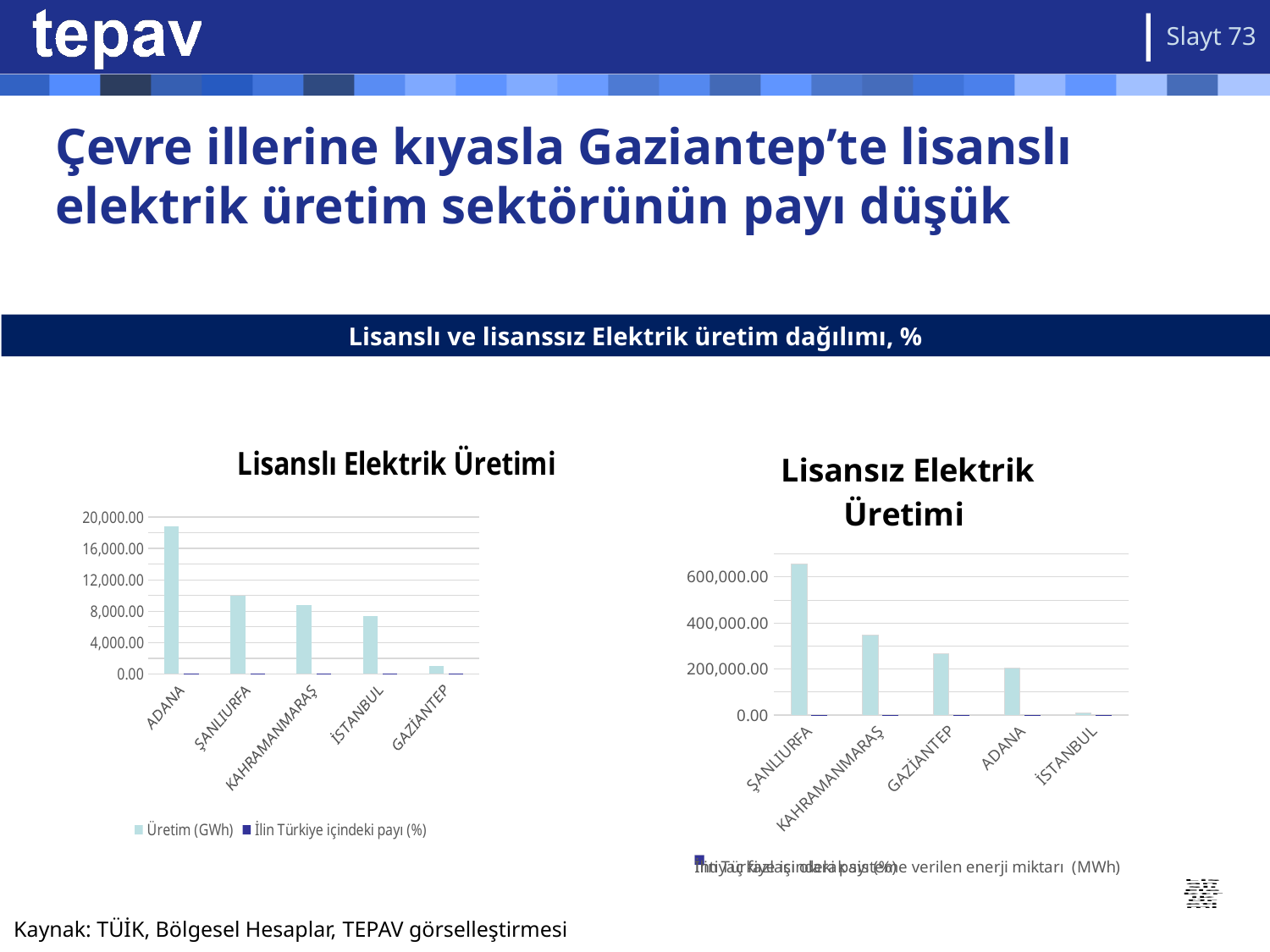
In the 'Lisanslı Elektrik Üretimi' chart, is the Üretim (GWh) value for GAZİANTEP greater or less than 4,000.00? less How many provinces are shown on the x axis of the 'Lisanslı Elektrik Üretimi' chart? 5 In the 'Lisansız Elektrik Üretimi' chart, do the tall bars rise or fall from left to right along the x axis? Fall In the 'Lisanslı Elektrik Üretimi' chart, which province has the highest Üretim (GWh) bar? ADANA In the 'Lisansız Elektrik Üretimi' chart, which province has the tallest bar? ŞANLIURFA In the 'Lisanslı Elektrik Üretimi' chart, is the Üretim (GWh) value for ADANA greater or less than 16,000.00? greater What type of chart is the 'Lisansız Elektrik Üretimi' chart? Bar chart In the 'Lisansız Elektrik Üretimi' chart, is the tallest bar for KAHRAMANMARAŞ greater or less than 400,000.00? less How many series does the legend of the 'Lisanslı Elektrik Üretimi' chart list? 2 In the 'Lisanslı Elektrik Üretimi' chart, which has the larger Üretim (GWh) bar, ŞANLIURFA or İSTANBUL? ŞANLIURFA In the 'Lisanslı Elektrik Üretimi' chart, which province has the lowest Üretim (GWh) bar? GAZİANTEP